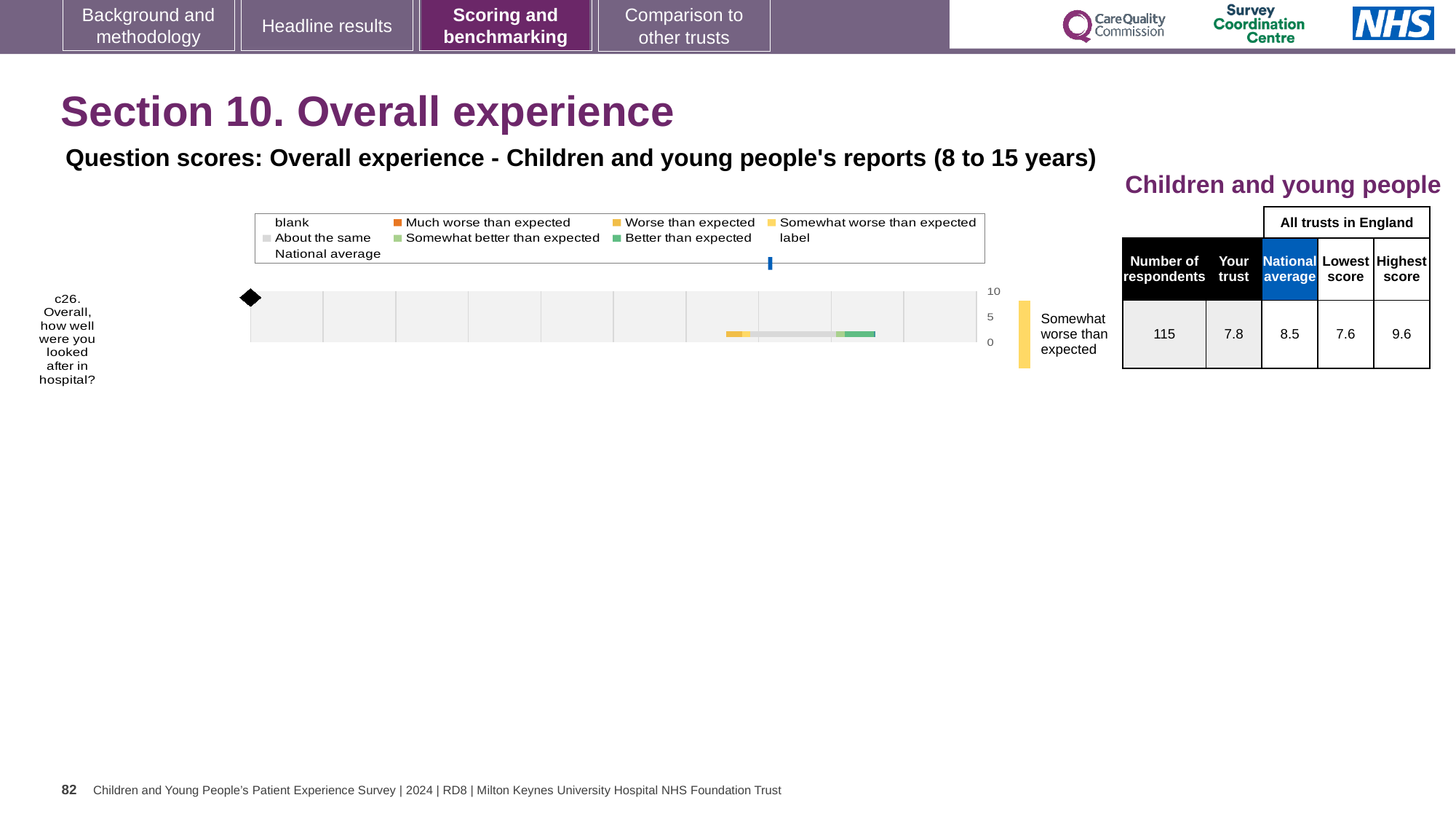
What is the difference between the national average and the trust's score for question c26? 0.7 What kind of chart is used to show the question score for c26? bar chart What is the difference between the highest score and the lowest score for question c26? 2.0 What benchmark category is the trust's result for question c26 labelled as? Somewhat worse than expected What is the lowest score among all trusts in England for question c26? 7.6 What is the 'Your trust' score for question c26, 'Overall, how well were you looked after in hospital?' 7.8 What is the highest score among all trusts in England for question c26? 9.6 How many survey questions are plotted in the chart? 1 What is the maximum value shown on the chart's score axis? 10 What is the national average score for question c26? 8.5 Which is larger for question c26: the trust's score or the national average? National average How many respondents answered question c26? 115